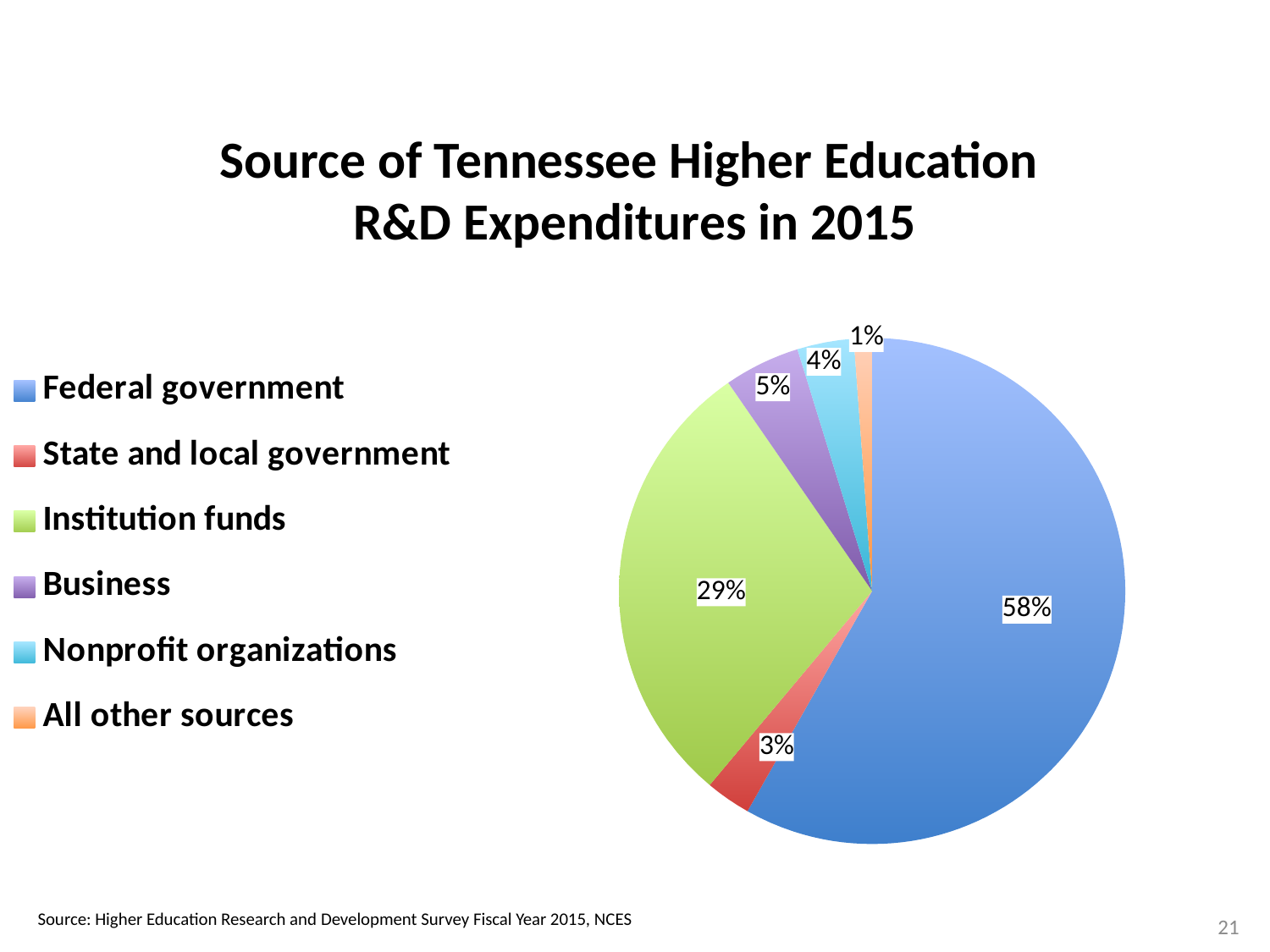
How many percentage points larger is the Federal government share than the Institution funds share? 29 What share of expenditures came from Nonprofit organizations? 4% What share of Tennessee higher education R&D expenditures in 2015 came from the Federal government? 58% What kind of chart is shown on the slide? Pie chart Which is larger, the share for Business or the share for Nonprofit organizations? Business What share of expenditures came from All other sources? 1% Which source accounts for the smallest share of the pie? All other sources How many sources are listed in the legend? 6 Which source accounts for the largest share of the pie? Federal government